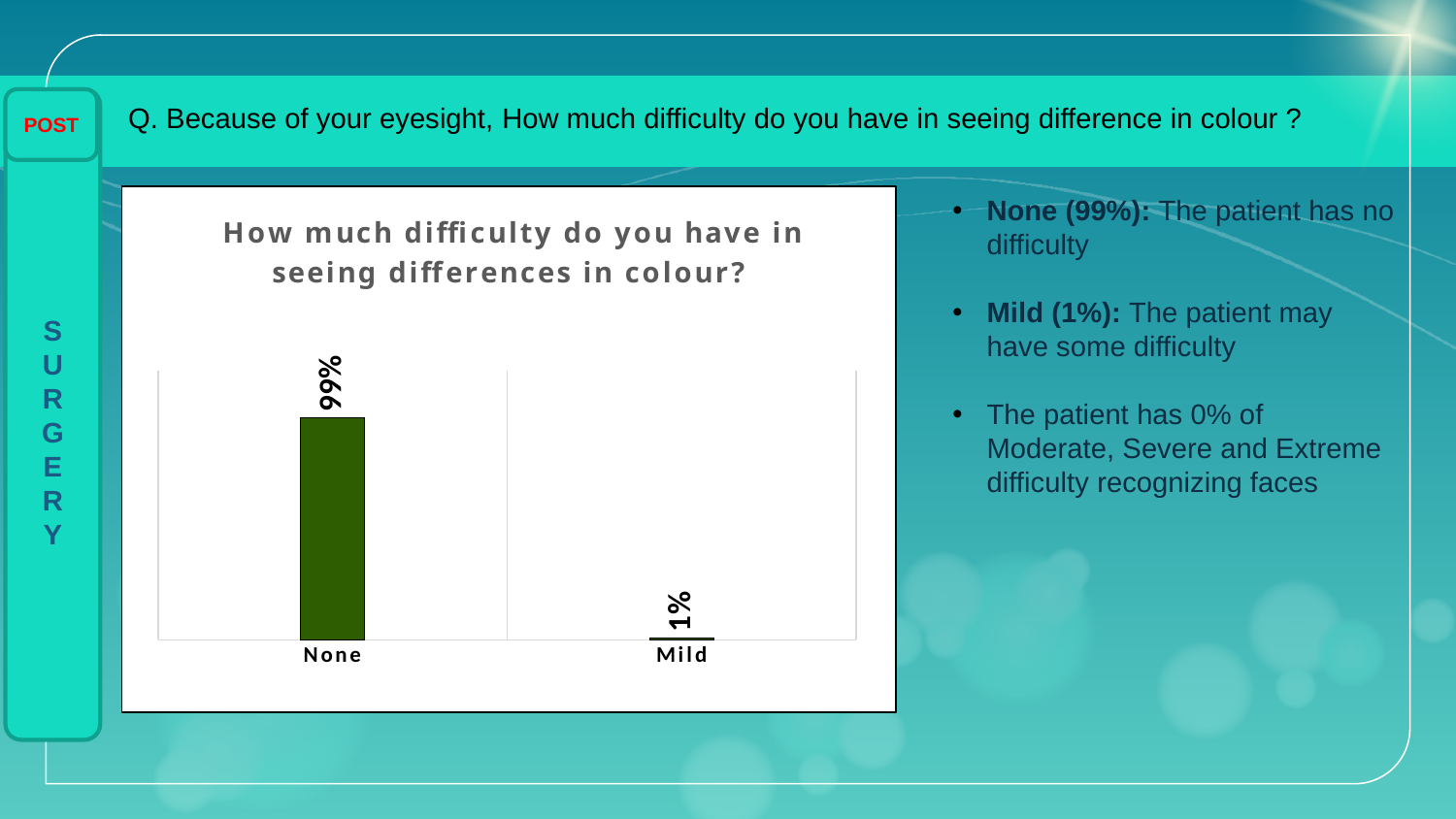
Which category has the highest value? None Do the values rise or fall from None to Mild along the x axis? Fall How many categories are shown on the x axis? 2 Which is larger, the value for None or the value for Mild? None What colour are the bars in the chart? Dark green What is the total of the values for None and Mild? 100% What is the value for None? 99% What is the title of the chart? How much difficulty do you have in seeing differences in colour? What kind of chart is shown on the slide? Bar chart Which category has the lowest value? Mild What is the difference between the values for None and Mild? 98% What is the value for Mild? 1%